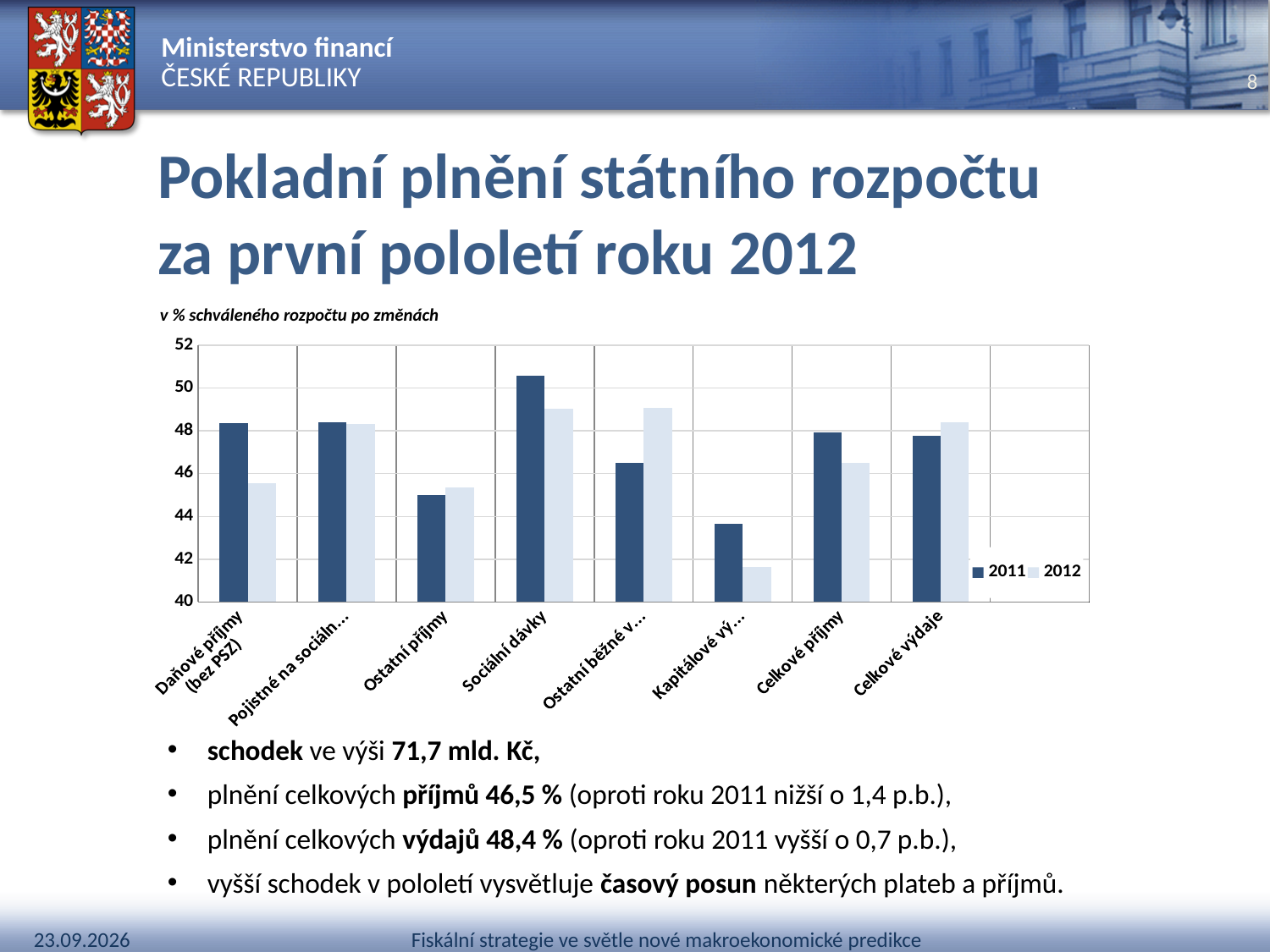
How many categories are shown on the x axis of the chart? 8 What unit note is printed above the chart? v % schváleného rozpočtu po změnách Which category has the highest value for the 2011 series? Sociální dávky For Daňové příjmy (bez PSZ), which series has the larger value, 2011 or 2012? 2011 For Celkové příjmy, which series has the larger value, 2011 or 2012? 2011 Is the 2011 value for Ostatní příjmy greater or less than 46? less What kind of chart is shown on the slide? bar chart Is the 2012 value for Daňové příjmy (bez PSZ) greater or less than 46? less For Celkové výdaje, which series has the larger value, 2011 or 2012? 2012 Is the 2011 value for Sociální dávky greater or less than 50? greater How many series does the chart legend list? 2 Which series is shown in dark blue in the chart? 2011